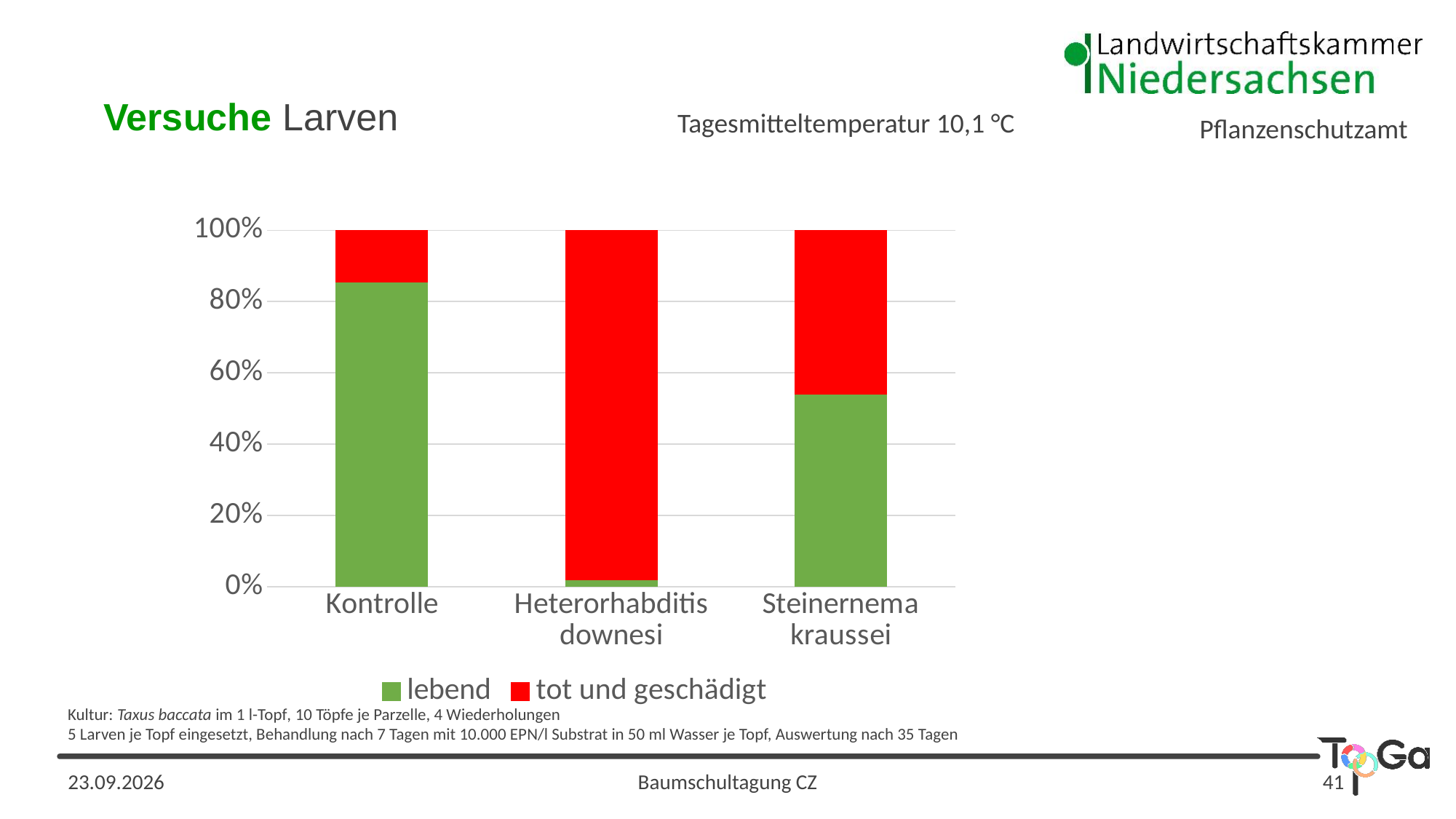
Which has a larger 'lebend' share: Kontrolle or Steinernema kraussei? Kontrolle How many categories are shown on the x axis of the chart? 3 Which category has the highest share of 'tot und geschädigt' (red)? Heterorhabditis downesi Is the 'lebend' share for Kontrolle greater or less than 80%? greater Which category has the highest share of 'lebend' (green)? Kontrolle Which category has the lowest share of 'lebend' (green)? Heterorhabditis downesi Is the 'lebend' share for Steinernema kraussei greater or less than 60%? less What is the total height of the stacked bar for Kontrolle? 100% What kind of chart is shown on the slide? stacked bar chart Which colour represents the series 'tot und geschädigt' in the chart? red How many series does the chart legend list? 2 Is the 'lebend' share for Heterorhabditis downesi greater or less than 20%? less